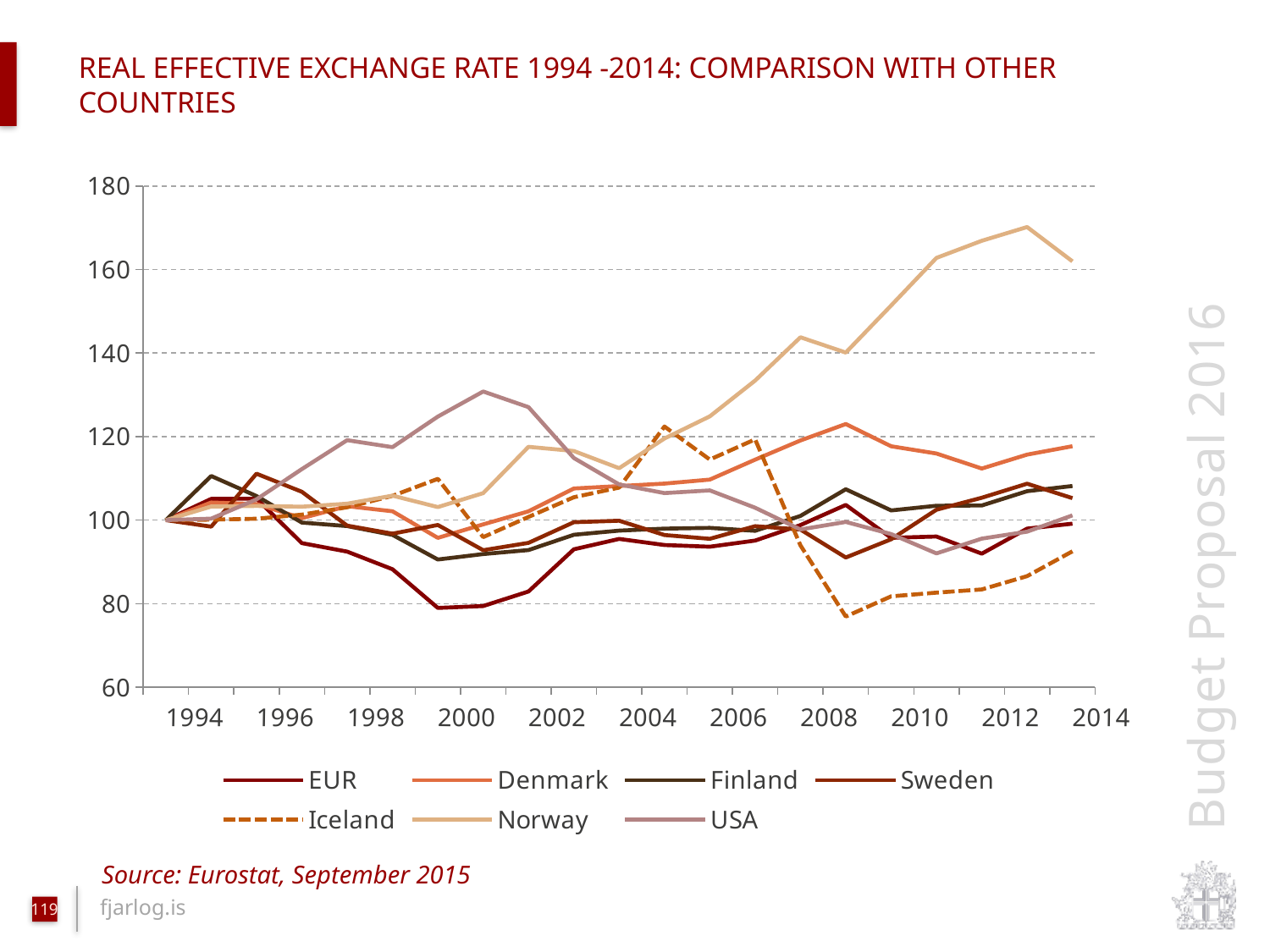
Which series has the lowest value in 2014? Iceland Which series has the highest value in 2000? USA Is the value for Iceland in 2008 greater or less than 100? less Which series has the highest value in 2014? Norway Which series is drawn with a dashed line? Iceland What kind of chart is shown on the slide? line chart How many series does the legend list? 7 Which series has the lowest value in 2000? EUR Is the value for USA in 2000 greater or less than 120? greater What is the source cited below the chart? Eurostat, September 2015 Does the Norway line rise or fall between 2006 and 2012? rise Is the value for Norway in 2012 greater or less than 160? greater